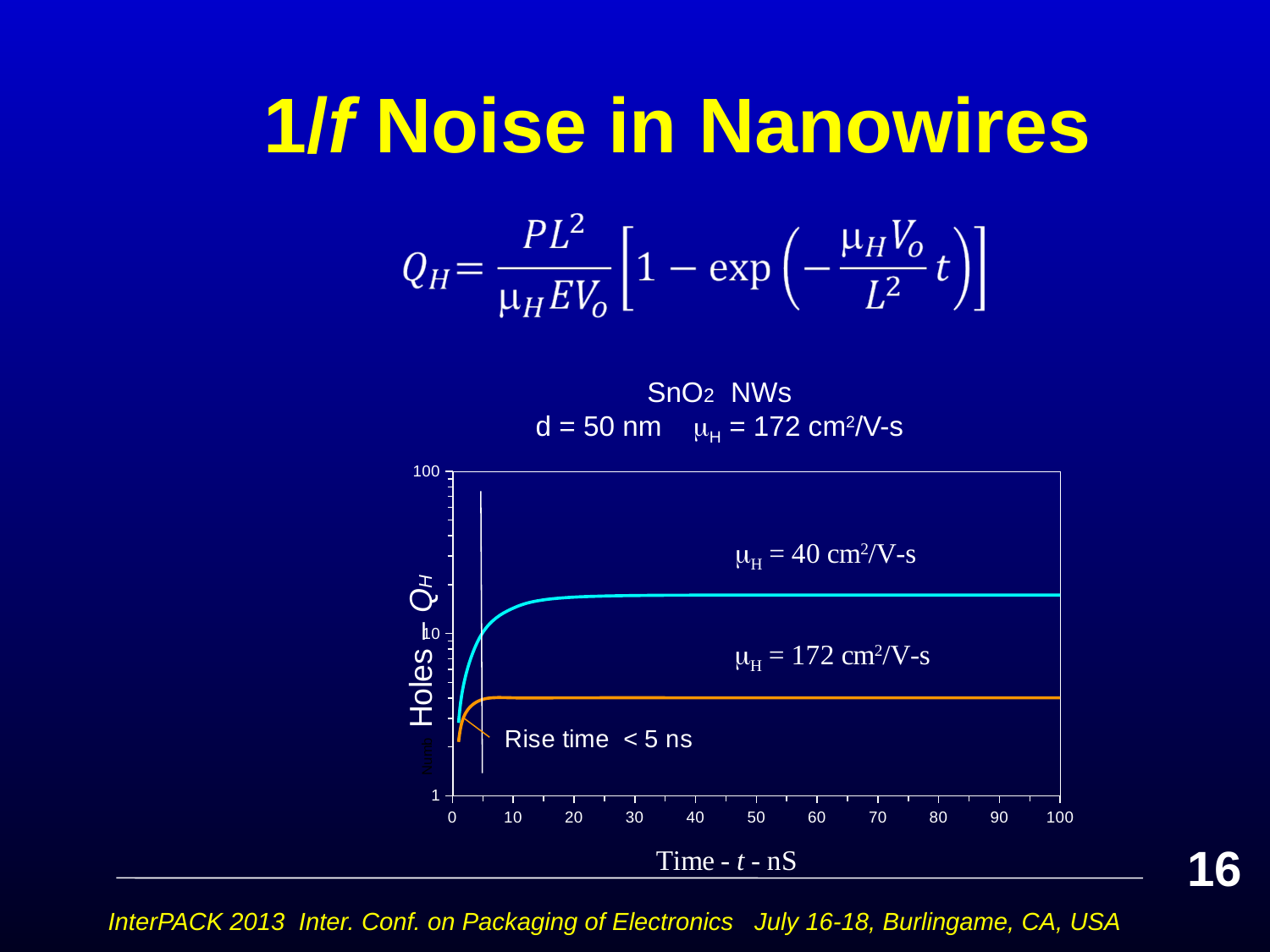
What is the label of the x axis? Time - t - nS Which curve reaches the higher plateau: μH = 40 cm²/V-s or μH = 172 cm²/V-s? μH = 40 cm²/V-s What is the highest tick value shown on the x axis? 100 Is the plateau value of the μH = 40 cm²/V-s curve greater or less than 100? less What is the lowest tick value shown on the y axis? 1 Is the plateau value of the μH = 172 cm²/V-s curve greater or less than 10? less What rise time is annotated on the chart? < 5 ns What kind of chart is shown on the slide? line chart How many curves are plotted on the chart? 2 How does the μH = 172 cm²/V-s curve behave along the time axis? rises quickly then stays flat Which curve has the lower plateau: μH = 40 cm²/V-s or μH = 172 cm²/V-s? μH = 172 cm²/V-s Is the plateau value of the μH = 40 cm²/V-s curve greater or less than 10? greater